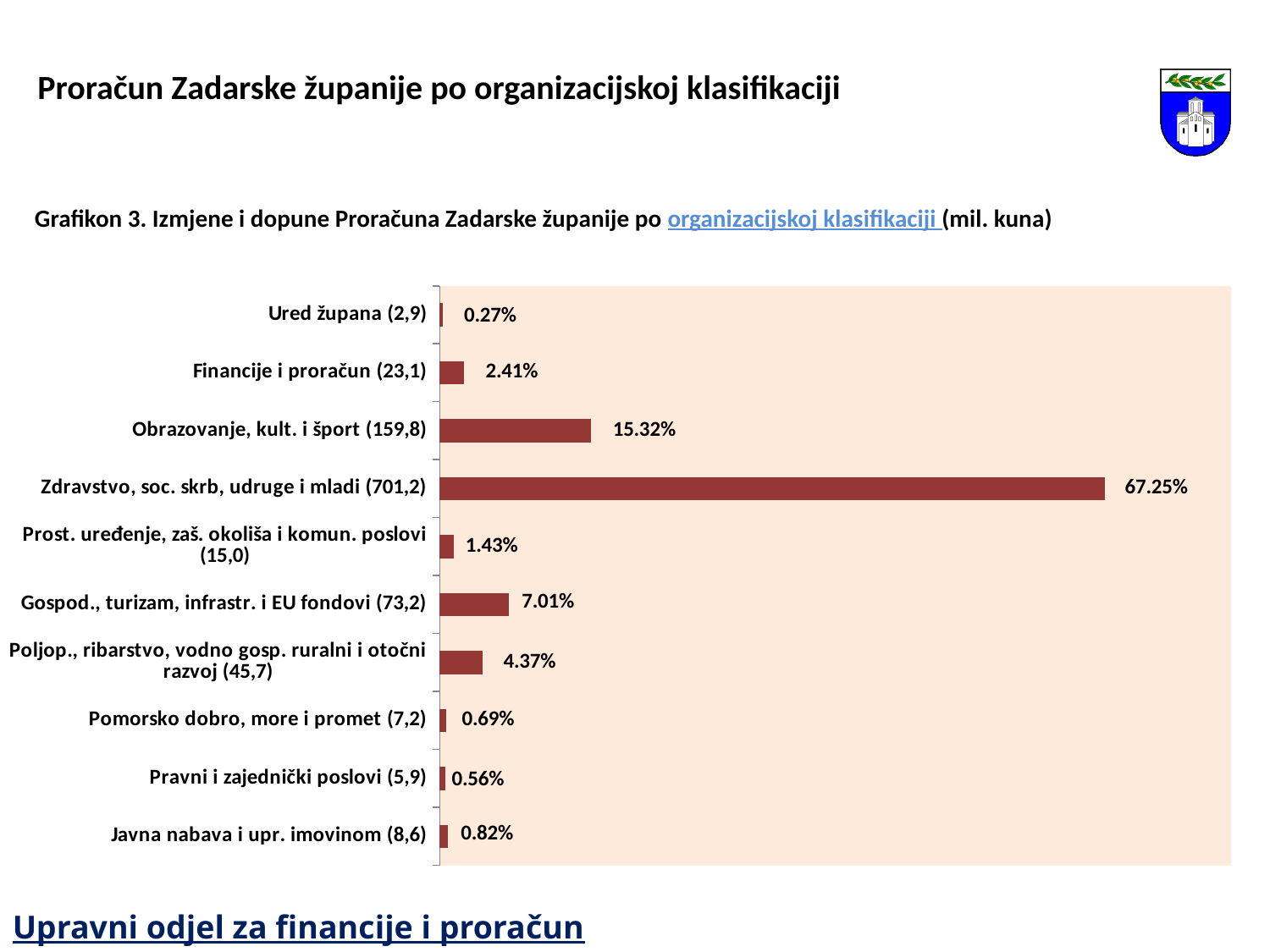
Which category has the lowest value? Ured župana What is the value shown for Zdravstvo, soc. skrb, udruge i mladi? 67.25% What is the value shown for Gospod., turizam, infrastr. i EU fondovi? 7.01% How many categories are shown in the chart? 10 Which is larger: the value for Financije i proračun or the value for Prost. uređenje, zaš. okoliša i komun. poslovi? Financije i proračun What unit is given in parentheses in the chart caption (Grafikon 3)? mil. kuna What is the value shown for Pravni i zajednički poslovi? 0.56% What is the value shown for Obrazovanje, kult. i šport? 15.32% Which category has the highest value? Zdravstvo, soc. skrb, udruge i mladi What kind of chart is shown on the slide? Bar chart What is the difference between the values for Obrazovanje, kult. i šport and Gospod., turizam, infrastr. i EU fondovi? 8.31% What is the difference between the values for Poljop., ribarstvo, vodno gosp. ruralni i otočni razvoj and Pomorsko dobro, more i promet? 3.68%